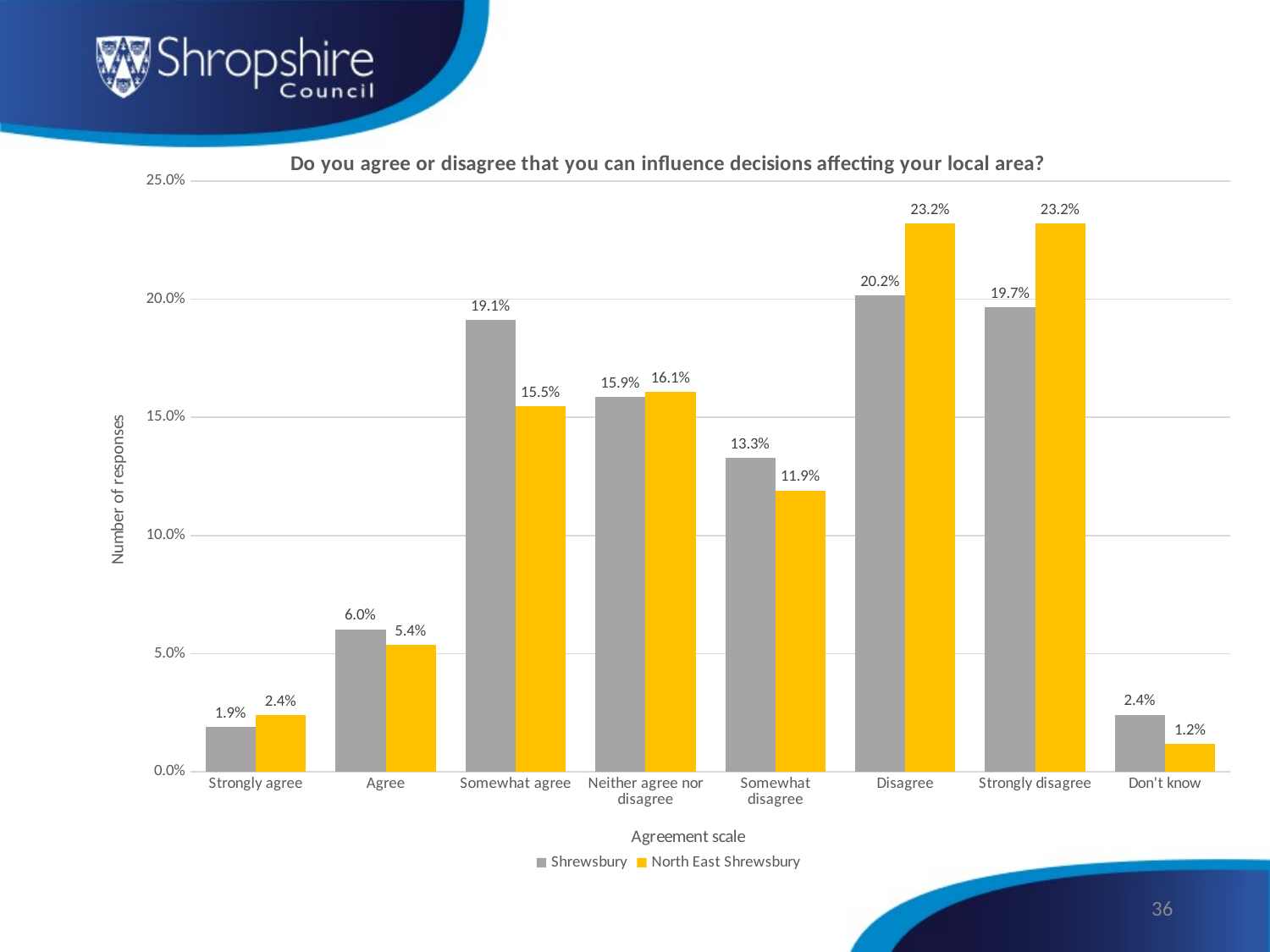
Which is larger for 'Strongly disagree': the Shrewsbury value or the North East Shrewsbury value? North East Shrewsbury Which category has the lowest value for the North East Shrewsbury series? Don't know What is the difference between the Shrewsbury and North East Shrewsbury values for 'Somewhat agree'? 3.6% What type of chart is shown on the slide? Bar chart What percentage of Shrewsbury respondents answered 'Somewhat agree'? 19.1% What is the title of the chart? Do you agree or disagree that you can influence decisions affecting your local area? Which category has the highest value for the Shrewsbury series? Disagree What is the value for North East Shrewsbury in the 'Somewhat disagree' category? 11.9% How many categories are shown on the x axis? 8 Is the Shrewsbury value for 'Disagree' greater or less than 20.0%? greater What is the value for Shrewsbury in the 'Don't know' category? 2.4% How many series does the legend list? 2